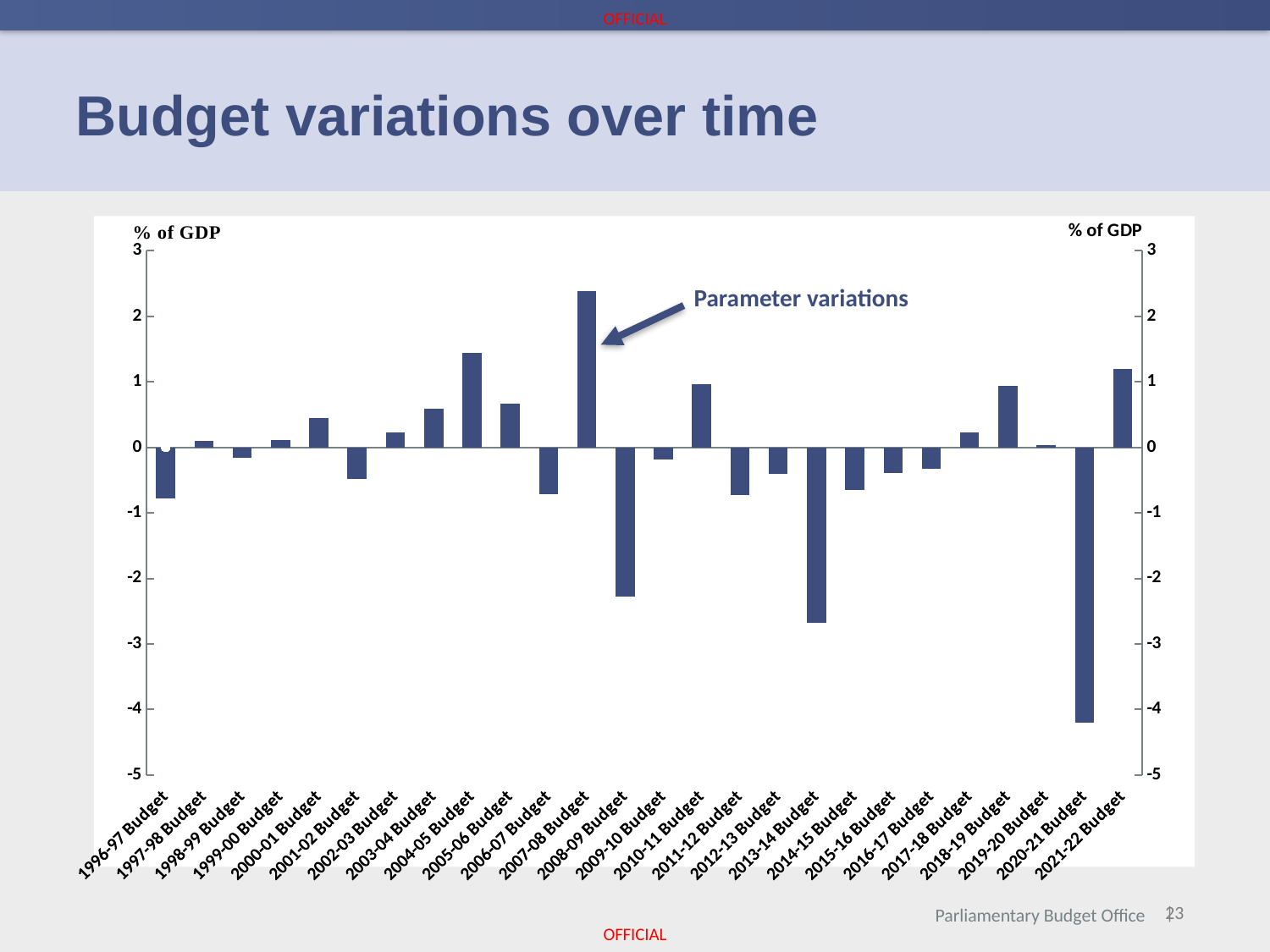
Is the value for the 2013-14 Budget greater or less than -2? less Which budget has the highest parameter variation? 2007-08 Budget Is the value for the 2021-22 Budget greater or less than 1? greater What unit is shown on the vertical axis label? % of GDP Is the value for the 2007-08 Budget greater or less than 2? greater Which budget has the lowest parameter variation? 2020-21 Budget What text does the arrow annotation on the chart point with? Parameter variations How many budgets (categories) are plotted on the x axis? 26 What kind of chart is shown on the slide? bar chart Which is larger, the value for the 2007-08 Budget or the 2004-05 Budget? 2007-08 Budget